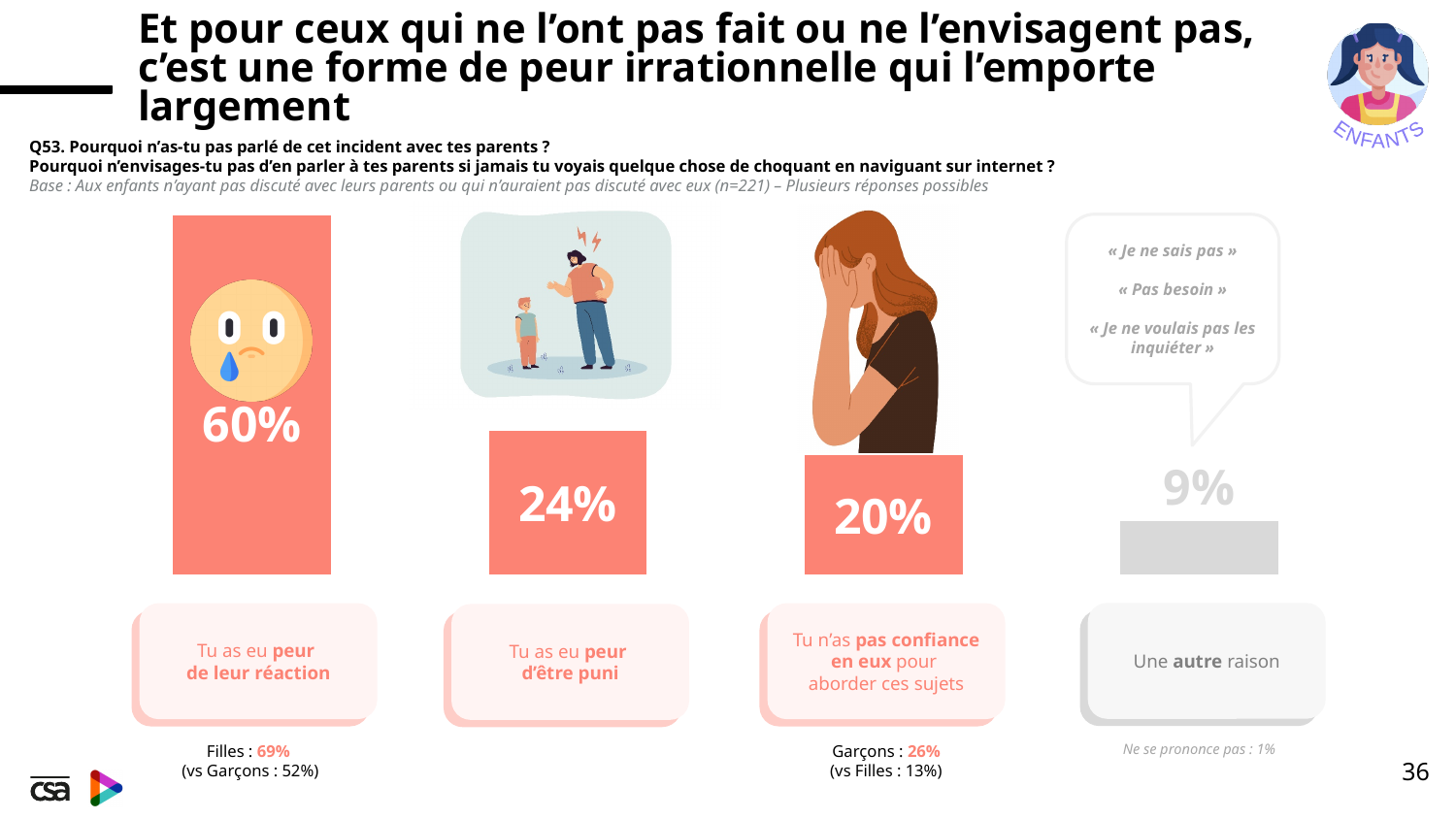
What percentage is shown for "Tu n'as pas confiance en eux pour aborder ces sujets"? 20% What percentage of girls (Filles) cite fear of their parents' reaction, compared with boys? 69% (vs Garçons : 52%) What percentage of boys (Garçons) say they do not trust their parents to discuss these subjects? 26% How many reasons are shown as bars on the chart? 4 What percentage of children cite "Tu as eu peur de leur réaction" as the reason? 60% What percentage is shown for "Tu as eu peur d'être puni"? 24% Which is larger: the percentage for "Tu as eu peur d'être puni" or for "Tu n'as pas confiance en eux"? Tu as eu peur d'être puni What kind of chart is used to show the reasons? Bar chart Which reason has the highest percentage? Tu as eu peur de leur réaction What is the difference in percentage points between "Tu as eu peur de leur réaction" and "Tu as eu peur d'être puni"? 36 points What percentage is shown for "Une autre raison"? 9% Which reason has the lowest percentage? Une autre raison